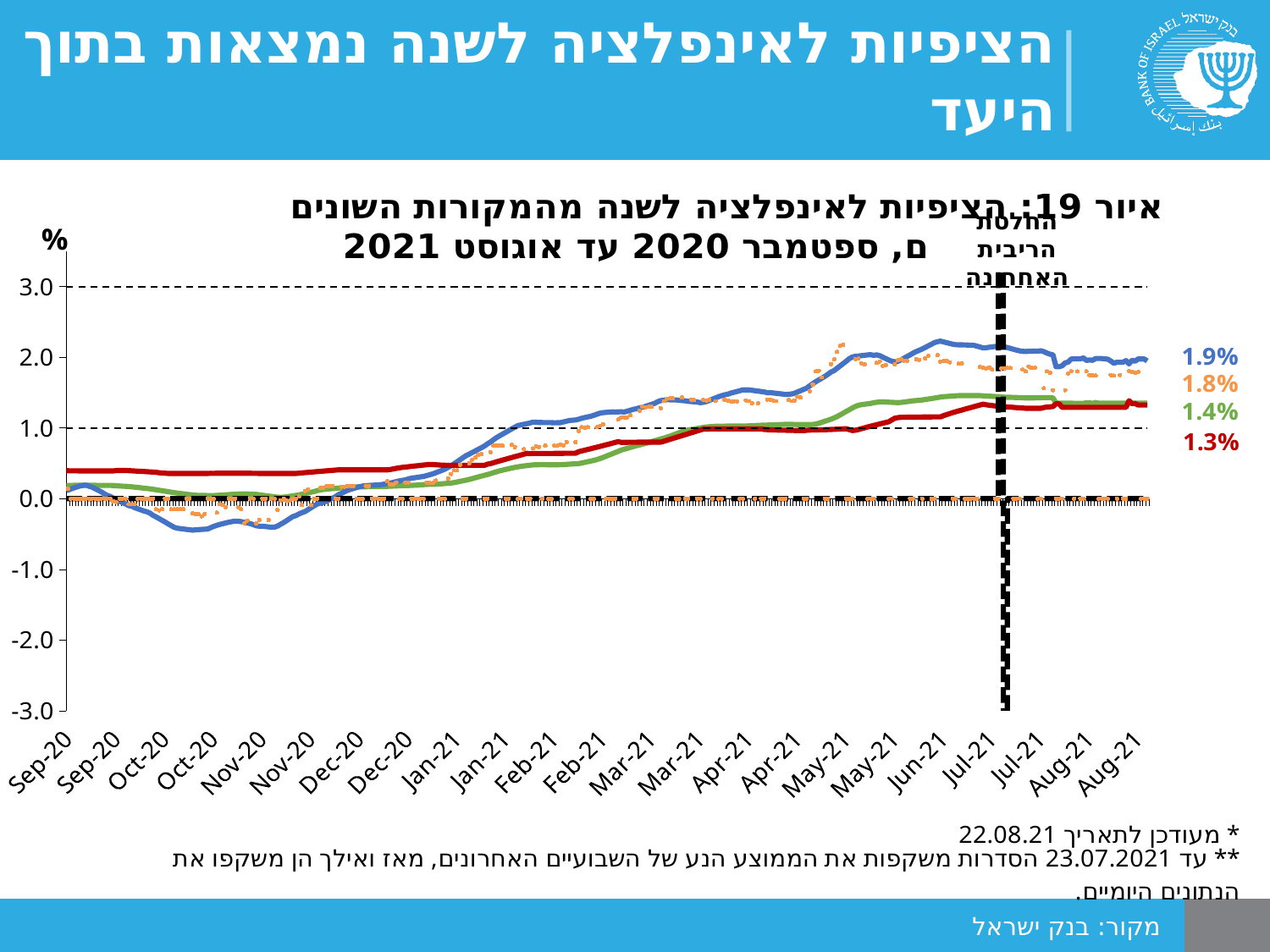
Is the value of the blue line around Nov-20 greater or less than 0.0? less What is the final value labelled for the blue line at the right end of the chart? 1.9% Which line has the lowest labelled end value? the red line (1.3%) What kind of chart is shown on the slide? line chart Which line has the highest labelled end value? the blue line (1.9%) Is the labelled end value of the green line larger or smaller than that of the orange dashed line? smaller What is the difference between the labelled end values of the blue line and the red line? 0.6 percentage points What is the final value labelled for the green line at the right end of the chart? 1.4% Does the blue line generally rise or fall from Sep-20 to Aug-21? rise What is the final value labelled for the red line at the right end of the chart? 1.3% What is the final value labelled for the orange dashed line at the right end of the chart? 1.8%